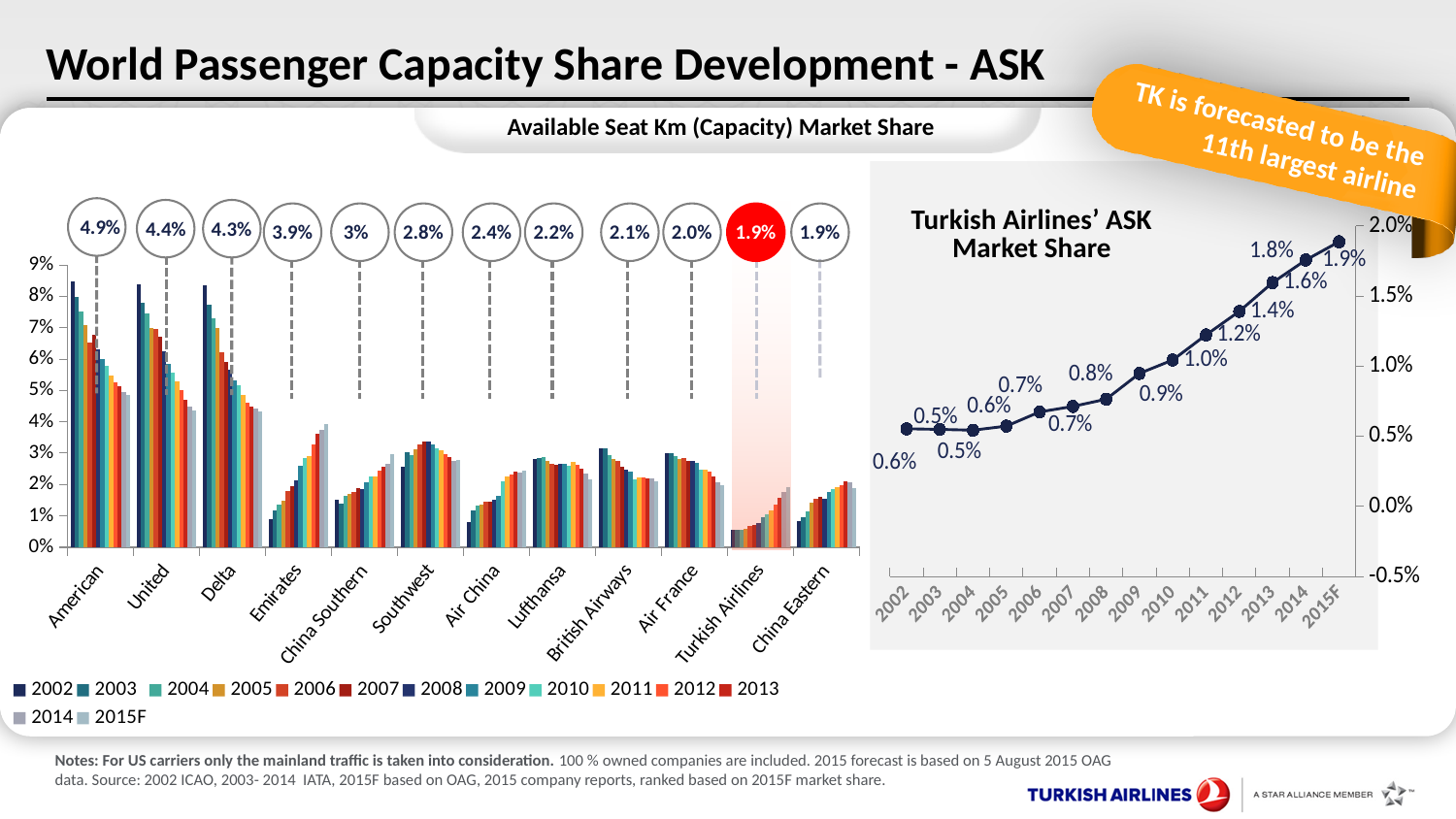
On the Turkish Airlines' ASK Market Share chart, what is the value for 2011? 1.2% On the Available Seat Km (Capacity) Market Share bar chart, is the 2002 bar for American greater or less than 8%? greater On the Available Seat Km (Capacity) Market Share bar chart, how many series does the legend list? 14 On the Turkish Airlines' ASK Market Share chart, what is the value for 2015F? 1.9% On the Available Seat Km (Capacity) Market Share bar chart, which airline has the highest circled value? American On the Available Seat Km (Capacity) Market Share bar chart, how many airlines are shown on the x axis? 12 On the Available Seat Km (Capacity) Market Share bar chart, what is the circled value shown above Emirates? 3.9% On the Turkish Airlines' ASK Market Share chart, do the values generally rise or fall from 2005 to 2015F? rise On the Turkish Airlines' ASK Market Share chart, what is the difference between the 2015F value and the 2002 value? 1.3% On the Available Seat Km (Capacity) Market Share bar chart, what is the difference between the circled values for United and Delta? 0.1% On the Available Seat Km (Capacity) Market Share bar chart, what is the circled value shown above American? 4.9% What kind of chart is the Turkish Airlines' ASK Market Share chart? line chart